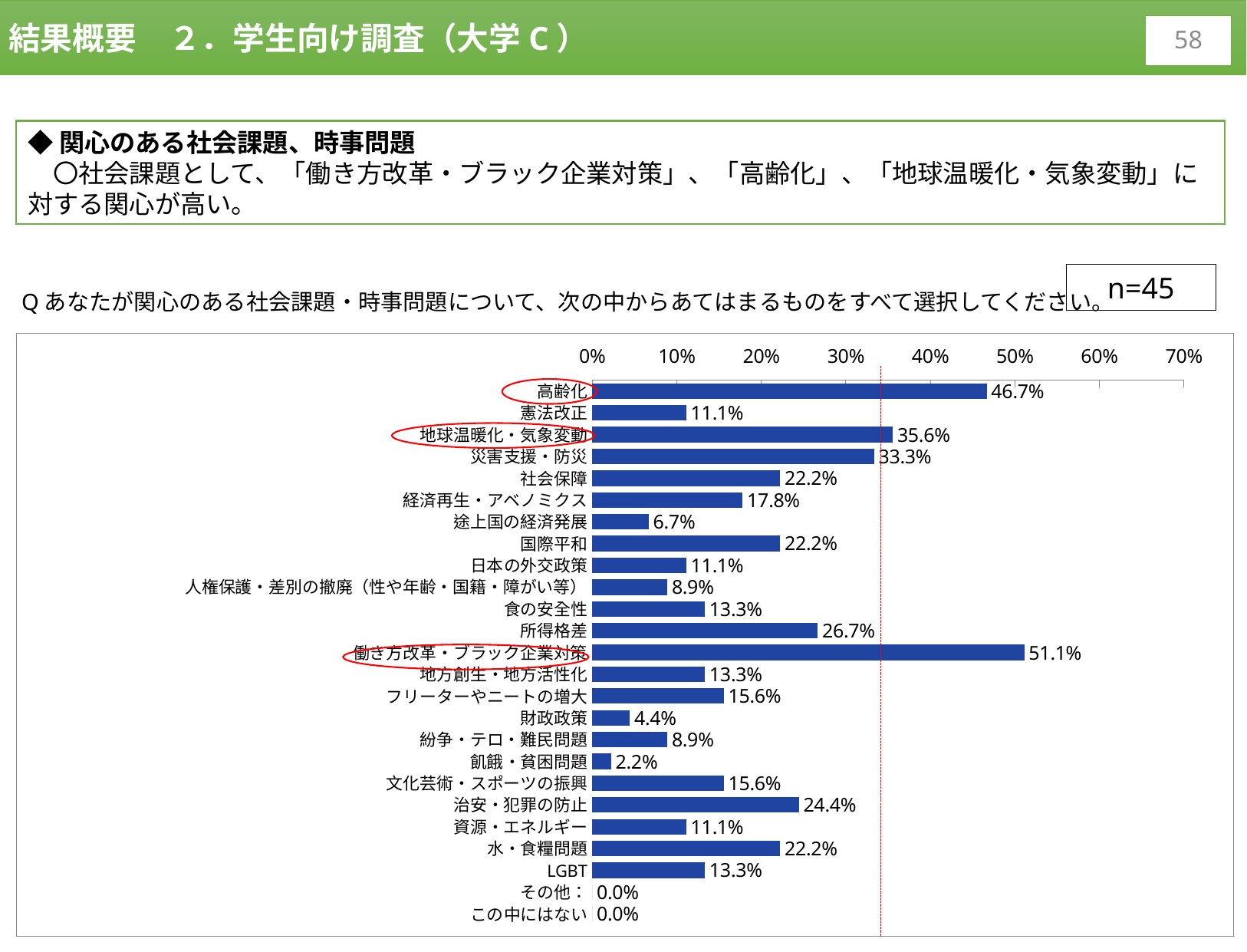
What is the difference between the values for 働き方改革・ブラック企業対策 and 高齢化? 4.4% Which category has the highest value? 働き方改革・ブラック企業対策 What is the value for 治安・犯罪の防止? 24.4% Is the value for 所得格差 greater or less than 20%? greater Which is larger, the value for 地球温暖化・気象変動 or the value for 災害支援・防災? 地球温暖化・気象変動 How many categories are shown in the chart? 25 What kind of chart is shown on the slide? bar chart What is the value for 高齢化? 46.7% What is the sample size (n) shown next to the question text? n=45 Among the categories with a non-zero value, which has the lowest value? 飢餓・貧困問題 What is the value for 働き方改革・ブラック企業対策? 51.1% What is the value for 飢餓・貧困問題? 2.2%